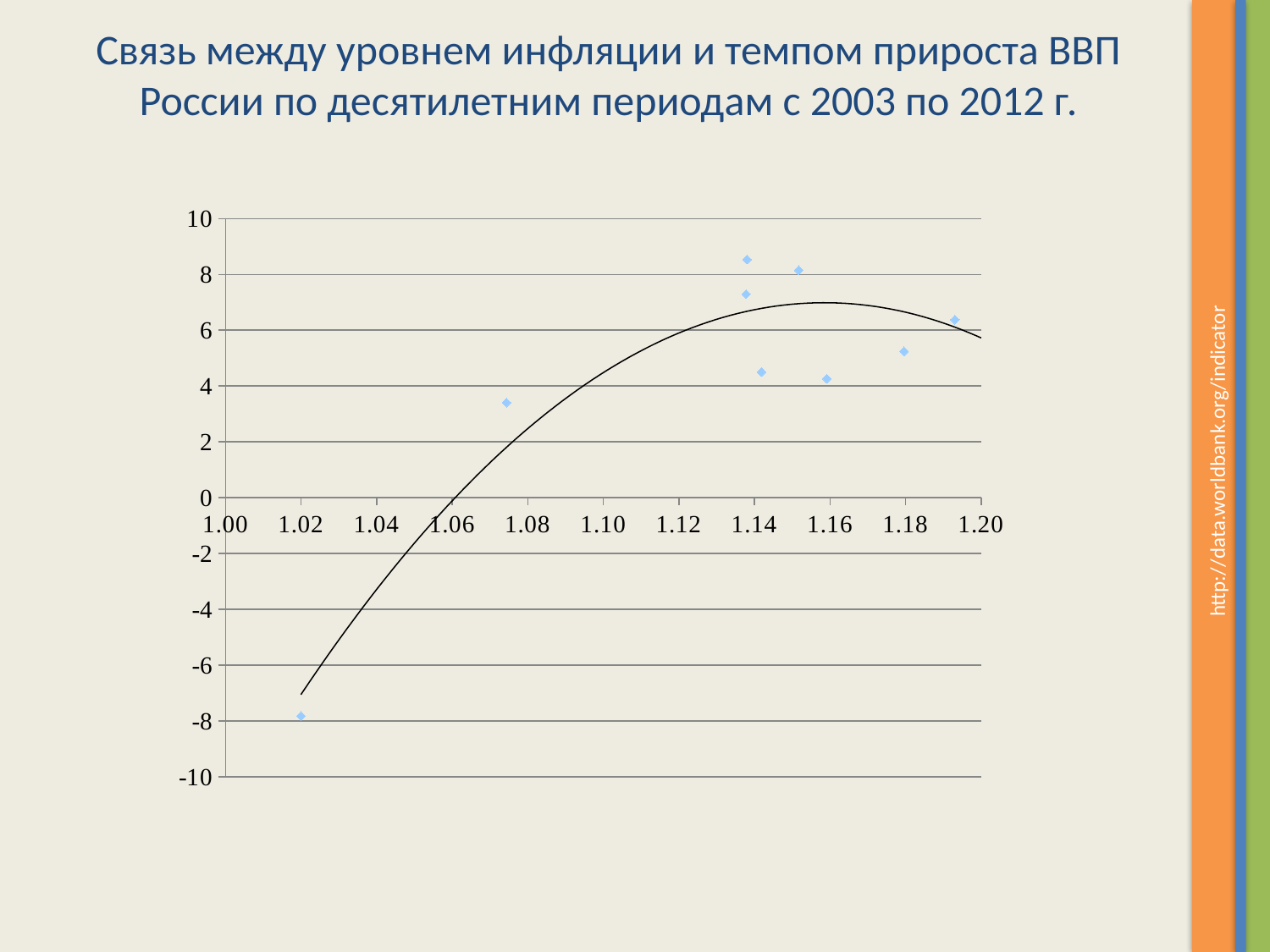
Does the fitted curve rise or fall as x increases from 1.02 to 1.14? rises Is the highest point on the chart greater or less than 8? greater What kind of chart is shown on the slide? scatter chart Which point is higher: the one at x ≈ 1.02 or the one at x ≈ 1.08? the one at x ≈ 1.08 Is the value of the point at x ≈ 1.02 greater or less than -6? less Which point has the lowest value on the chart? the point at x ≈ 1.02 Is the value of the point at x ≈ 1.19 greater or less than 6? greater What is the range of the vertical axis? -10 to 10 What is the title of the chart? Связь между уровнем инфляции и темпом прироста ВВП России по десятилетним периодам с 2003 по 2012 г.